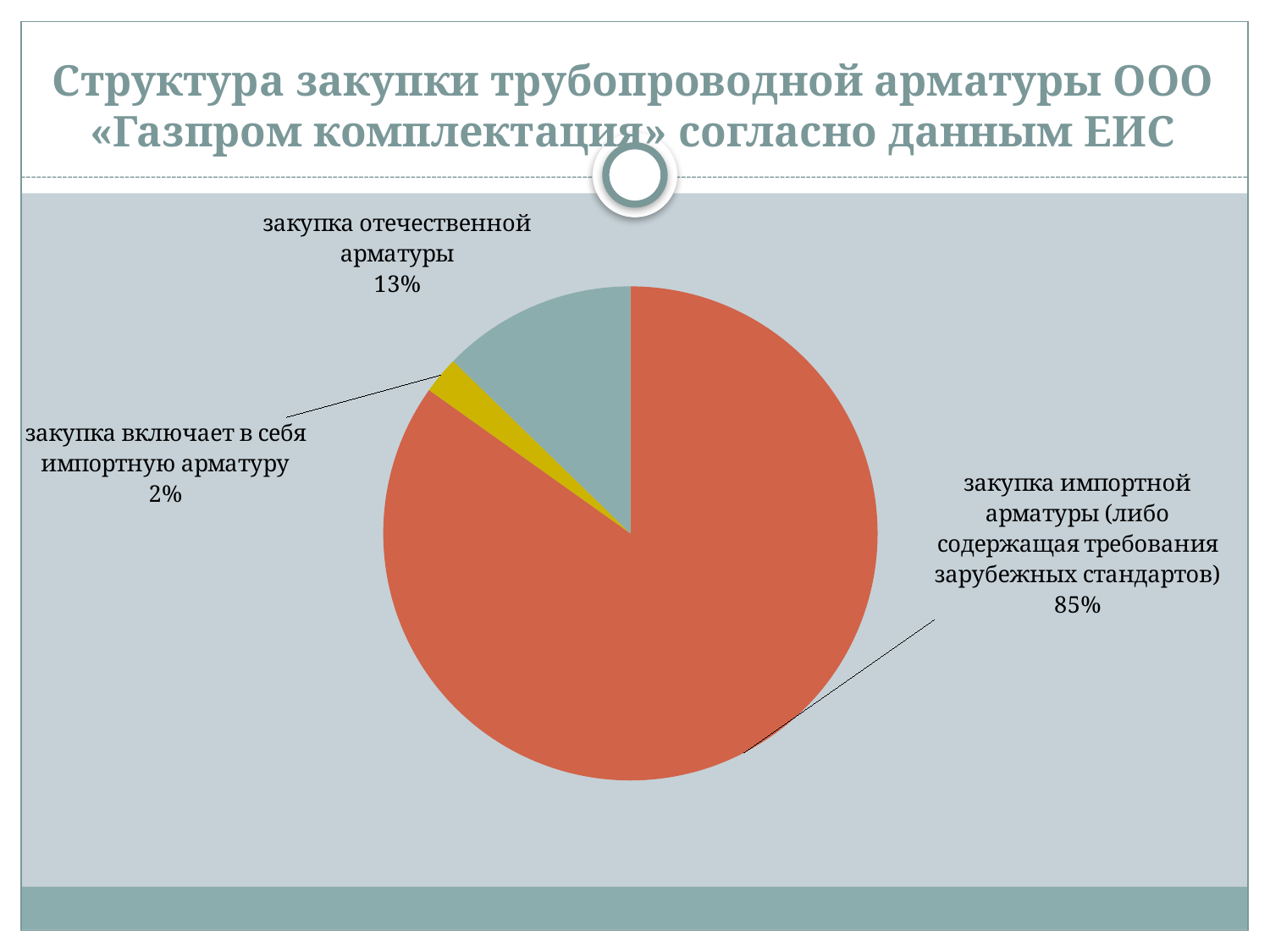
Which slice of the pie is the largest? закупка импортной арматуры (либо содержащая требования зарубежных стандартов) What colour is the largest slice of the pie? red Which slice of the pie is the smallest? закупка включает в себя импортную арматуру What is the difference in percentage points between the «закупка импортной арматуры» slice and the «закупка отечественной арматуры» slice? 72 Which is larger: the «закупка отечественной арматуры» slice or the «закупка включает в себя импортную арматуру» slice? закупка отечественной арматуры What kind of chart is shown on the slide? pie chart How many slices does the pie chart have? 3 What share of the pie is labelled «закупка включает в себя импортную арматуру»? 2% What share of the pie is labelled «закупка отечественной арматуры»? 13% What share of the pie is labelled «закупка импортной арматуры (либо содержащая требования зарубежных стандартов)»? 85% What is the difference in percentage points between the «закупка отечественной арматуры» slice and the «закупка включает в себя импортную арматуру» slice? 11 What colour is the slice labelled «закупка включает в себя импортную арматуру»? yellow